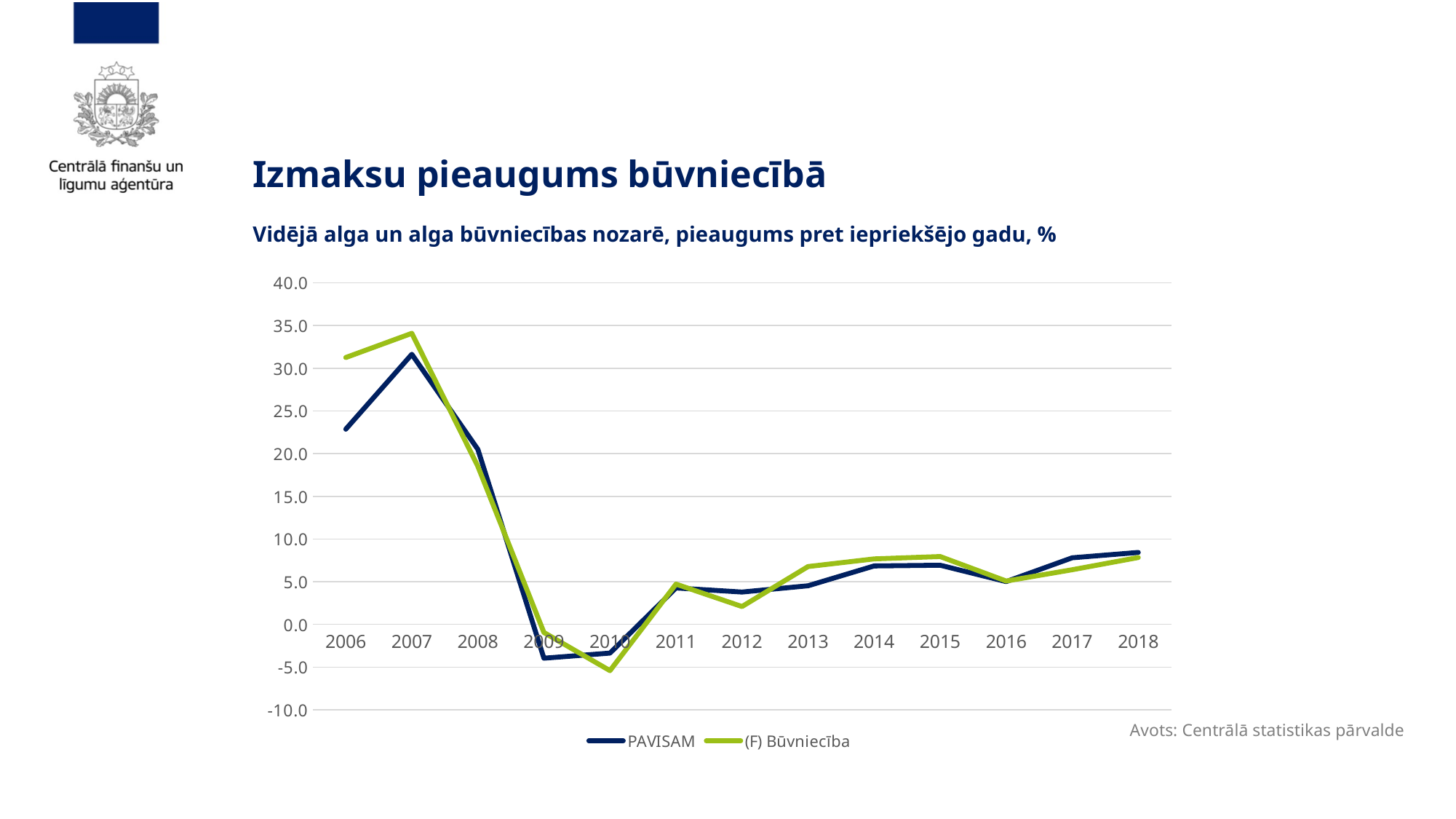
Is the value for (F) Būvniecība in 2010 greater or less than 0.0? less In which year does the (F) Būvniecība series reach its lowest value? 2010 Is the value for (F) Būvniecība in 2007 greater or less than 30.0? greater Do the values of the PAVISAM series rise or fall from 2007 to 2009? fall How many years are plotted along the x axis? 13 How many series does the legend list? 2 Is the value for PAVISAM in 2006 greater or less than 20.0? greater In 2006, which series has the higher value, PAVISAM or (F) Būvniecība? (F) Būvniecība What kind of chart is shown on the slide? line chart In which year does the (F) Būvniecība series reach its highest value? 2007 In which year does the PAVISAM series reach its highest value? 2007 In 2012, which series has the higher value, PAVISAM or (F) Būvniecība? PAVISAM